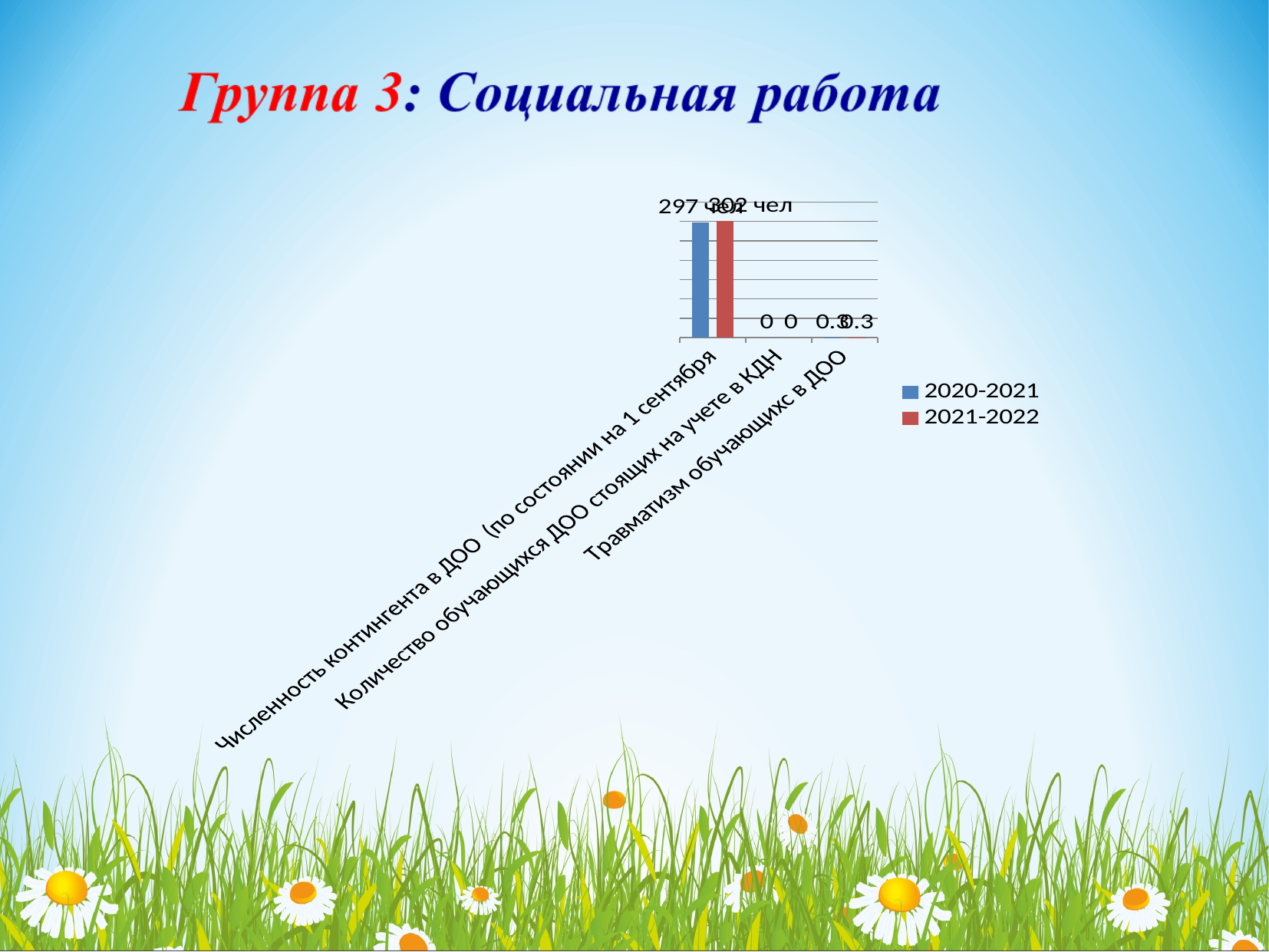
What kind of chart is shown on the slide? Bar chart By how much does the 2021-2022 value for 'Численность контингента в ДОО' exceed the 2020-2021 value? 5 чел How many series does the chart legend list? 2 How many categories are shown on the x axis of the chart? 3 What is the 2021-2022 value for 'Травматизм обучающихся в ДОО'? 0.3 What is the 2021-2022 value for 'Численность контингента в ДОО (по состоянии на 1 сентября'? 302 чел For 'Численность контингента в ДОО', which series has the larger value, 2020-2021 or 2021-2022? 2021-2022 What colour represents the 2021-2022 series in the chart? Red What is the 2020-2021 value for 'Численность контингента в ДОО (по состоянии на 1 сентября'? 297 чел Which category has the lowest value for the 2020-2021 series? Количество обучающихся ДОО стоящих на учете в КДН Which category has the highest value for the 2021-2022 series? Численность контингента в ДОО (по состоянии на 1 сентября What is the 2020-2021 value for 'Количество обучающихся ДОО стоящих на учете в КДН'? 0